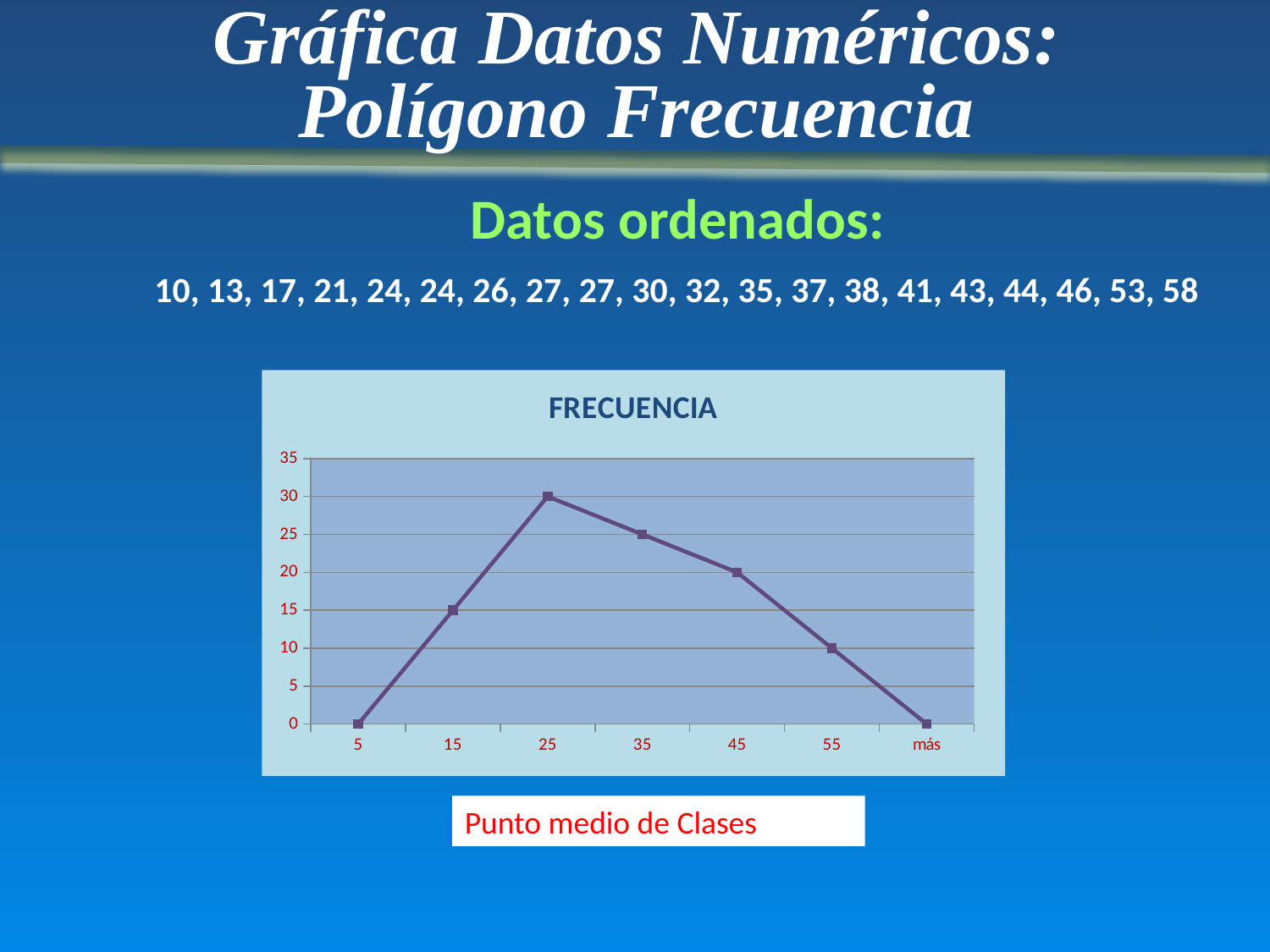
Which is larger in the FRECUENCIA chart, the value at 35 or the value at 55? 35 What is the value at the category 15 in the FRECUENCIA chart? 15 What is the value at the category 25 in the FRECUENCIA chart? 30 What is the value at the category 55 in the FRECUENCIA chart? 10 How many points are plotted on the line in the FRECUENCIA chart? 7 What is the title of the chart? FRECUENCIA What is the difference between the values at 25 and 45 in the FRECUENCIA chart? 10 What is the label of the last category on the x axis of the FRECUENCIA chart? más Do the values rise or fall along the x axis from 25 to 55 in the FRECUENCIA chart? fall Is the value at 45 in the FRECUENCIA chart greater or less than 15? greater What kind of chart is shown on the slide? line chart Which category has the highest value in the FRECUENCIA chart? 25